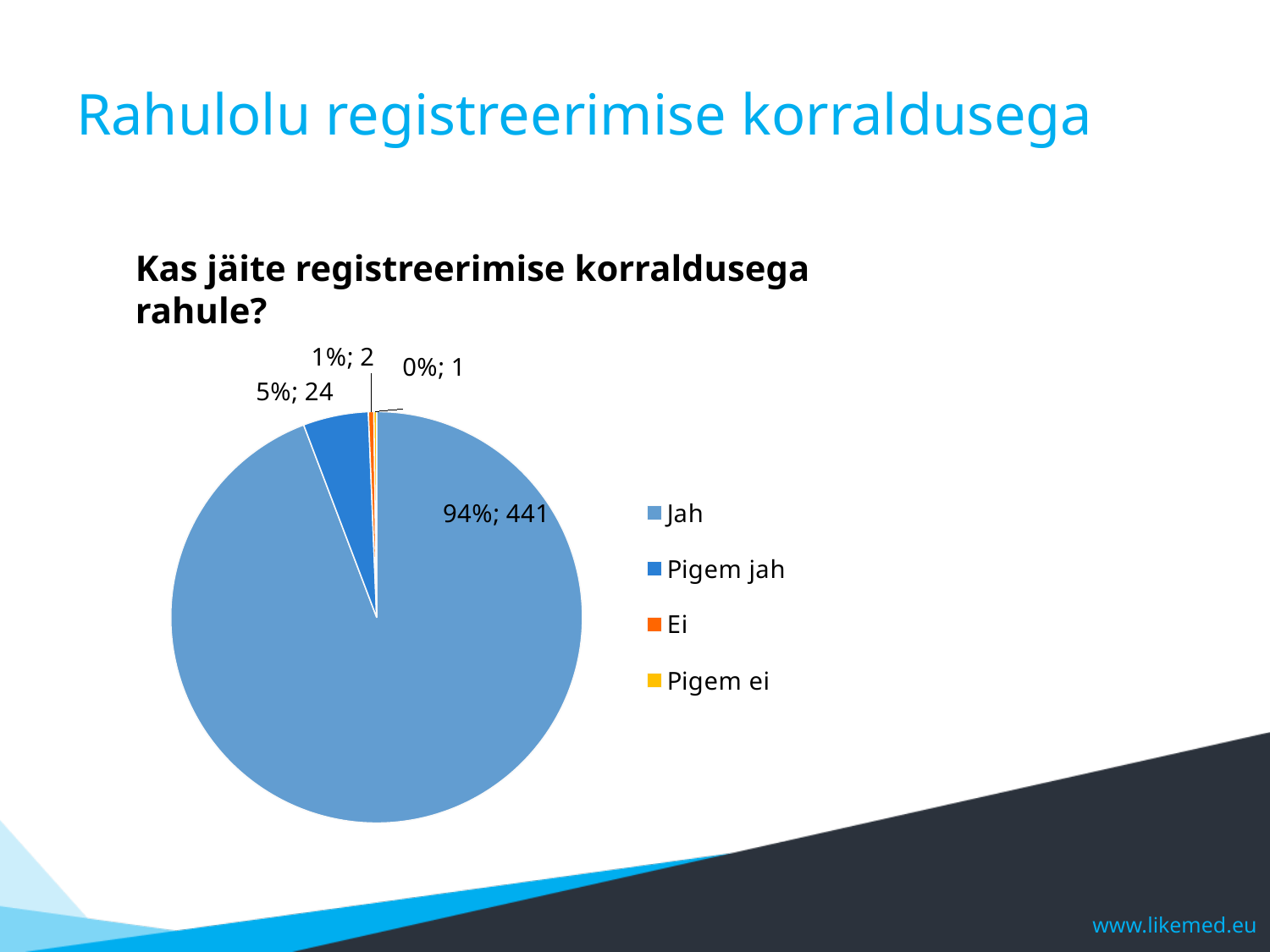
How many responses are 'Ei'? 2 Which category has the largest slice of the pie? Jah Which category has the smallest slice of the pie? Pigem ei What kind of chart is shown on the slide? pie chart What percentage of responses is 'Pigem jah'? 5% How many responses are 'Pigem ei'? 1 What percentage of responses is 'Jah'? 94% What is the difference in the number of responses between 'Jah' and 'Pigem jah'? 417 How many responses are 'Jah'? 441 How many responses are 'Pigem jah'? 24 How many categories does the legend of the pie chart list? 4 What is the title of the chart? Kas jäite registreerimise korraldusega rahule?